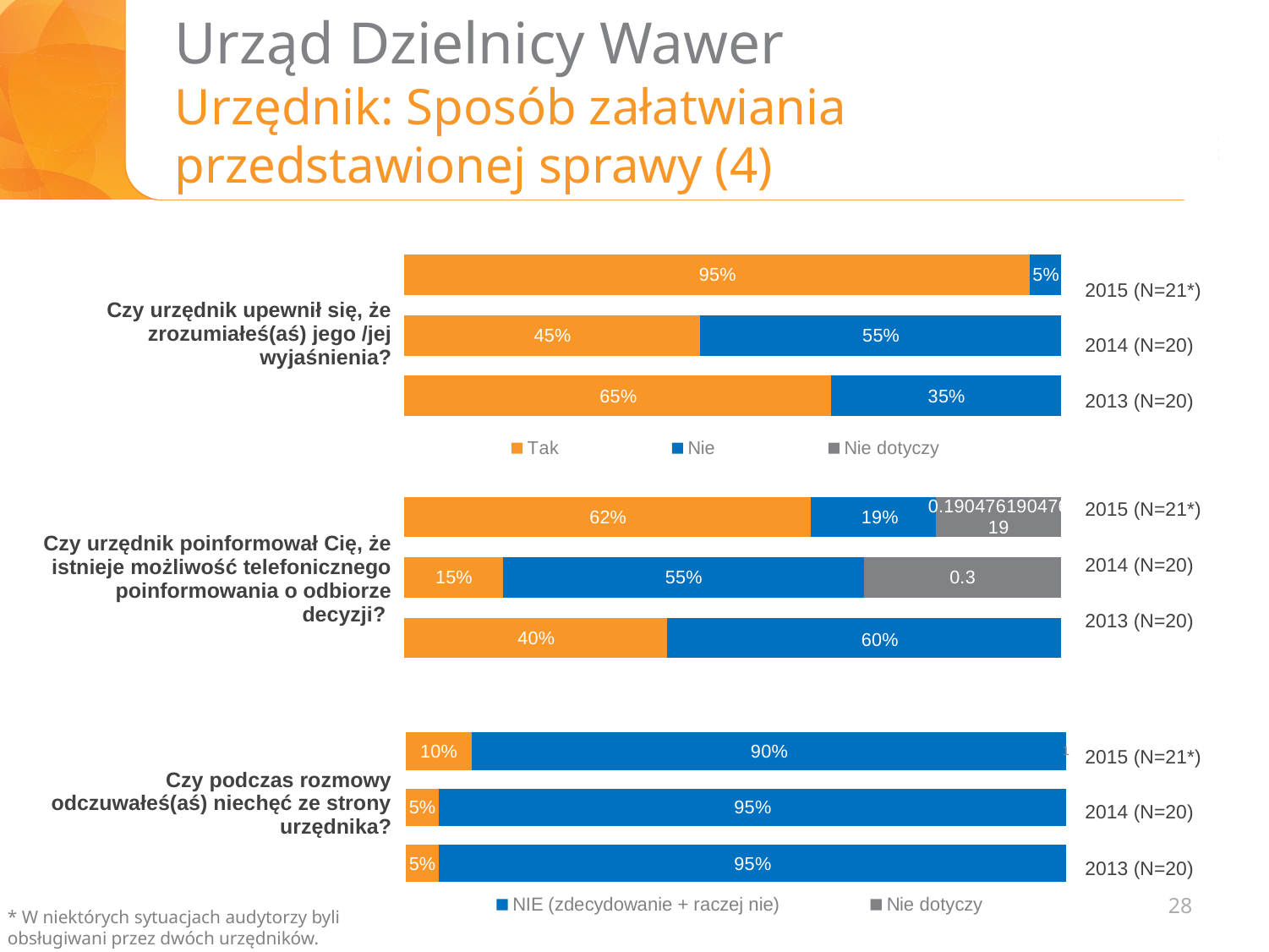
In the bottom chart ("Czy podczas rozmowy odczuwałeś(aś) niechęć ze strony urzędnika?"), what is the value of the blue "NIE (zdecydowanie + raczej nie)" segment for 2015 (N=21*)? 90% In the top chart, what is the value of "Nie" for 2014 (N=20)? 55% In the middle chart, which year has the lowest "Tak" value? 2014 (N=20) How many year bars does the bottom chart show? 3 In the middle chart ("Czy urzędnik poinformował Cię, że istnieje możliwość telefonicznego poinformowania o odbiorze decyzji?"), what is the value of the orange "Tak" segment for 2015 (N=21*)? 62% In the bottom chart, what is the value of the orange segment for 2015 (N=21*)? 10% In the top chart ("Czy urzędnik upewnił się, że zrozumiałeś(aś) jego /jej wyjaśnienia?"), what is the value of "Tak" for 2015 (N=21*)? 95% In the top chart, which year has the highest "Tak" value? 2015 (N=21*) In the middle chart, what is the value of the blue "Nie" segment for 2013 (N=20)? 60% In the top chart, what is the difference between the "Tak" values for 2013 (N=20) and 2014 (N=20)? 20% In the middle chart, is the "Tak" value for 2014 (N=20) larger or smaller than the "Tak" value for 2013 (N=20)? smaller What type of chart is used on this slide? Stacked bar chart